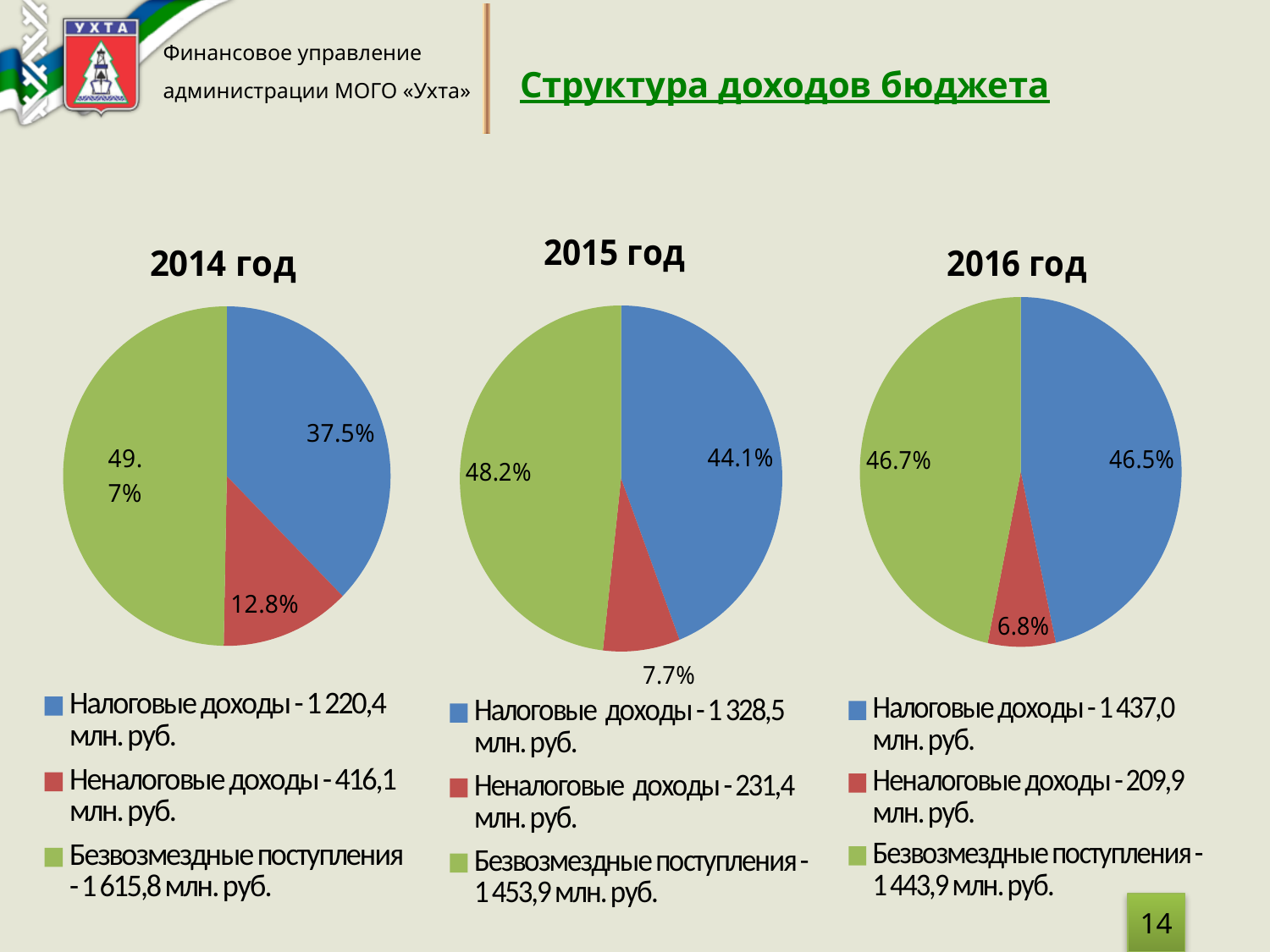
In the 2015 год pie chart, what share is shown for Неналоговые доходы? 7.7% In the 2015 год pie chart, what is the difference in percentage points between Безвозмездные поступления and Налоговые доходы? 4.1 How many slices does the 2015 год pie chart have? 3 In the 2014 год pie chart, which is larger: the share of Налоговые доходы or the share of Неналоговые доходы? Налоговые доходы In the 2016 год pie chart, which category has the smallest share? Неналоговые доходы According to the legend of the 2016 год chart, what is the amount of Налоговые доходы in млн. руб.? 1 437,0 млн. руб. What type of chart is used for 2016 год? Pie chart In the 2014 год pie chart, what share is shown for Налоговые доходы? 37.5% According to the legend of the 2014 год chart, what is the amount of Неналоговые доходы in млн. руб.? 416,1 млн. руб. In the 2015 год pie chart, what colour is the slice for Безвозмездные поступления? Green In the 2016 год pie chart, what share is shown for Безвозмездные поступления? 46.7% In the 2014 год pie chart, which category has the largest share? Безвозмездные поступления